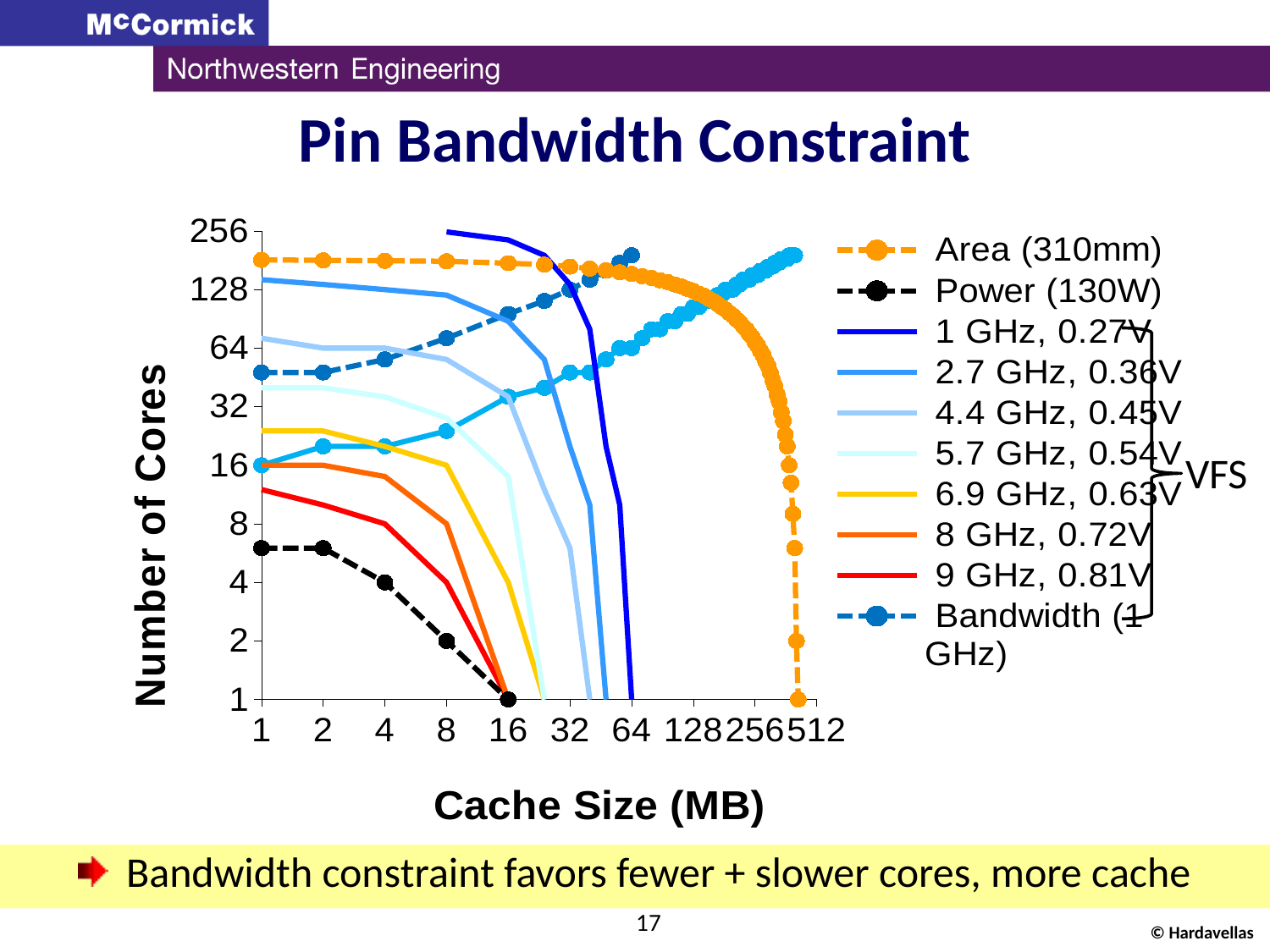
Is the value of the Power (130W) series at a cache size of 1 MB greater or less than 8? less What is the label of the y axis? Number of Cores What is the value of the Power (130W) series at a cache size of 16 MB? 1 Does the Power (130W) series rise or fall as cache size increases? fall Does the Bandwidth (1 GHz) series rise or fall as cache size increases? rise At a cache size of 16 MB, which is larger: the Bandwidth (1 GHz) series or the Power (130W) series? Bandwidth (1 GHz) What is the value of the Power (130W) series at a cache size of 4 MB? 4 How many series does the legend list? 10 What kind of chart is shown on the slide? line chart Is the value of the Area (310mm) series at a cache size of 1 MB greater or less than 128? greater What is the title of the chart? Pin Bandwidth Constraint